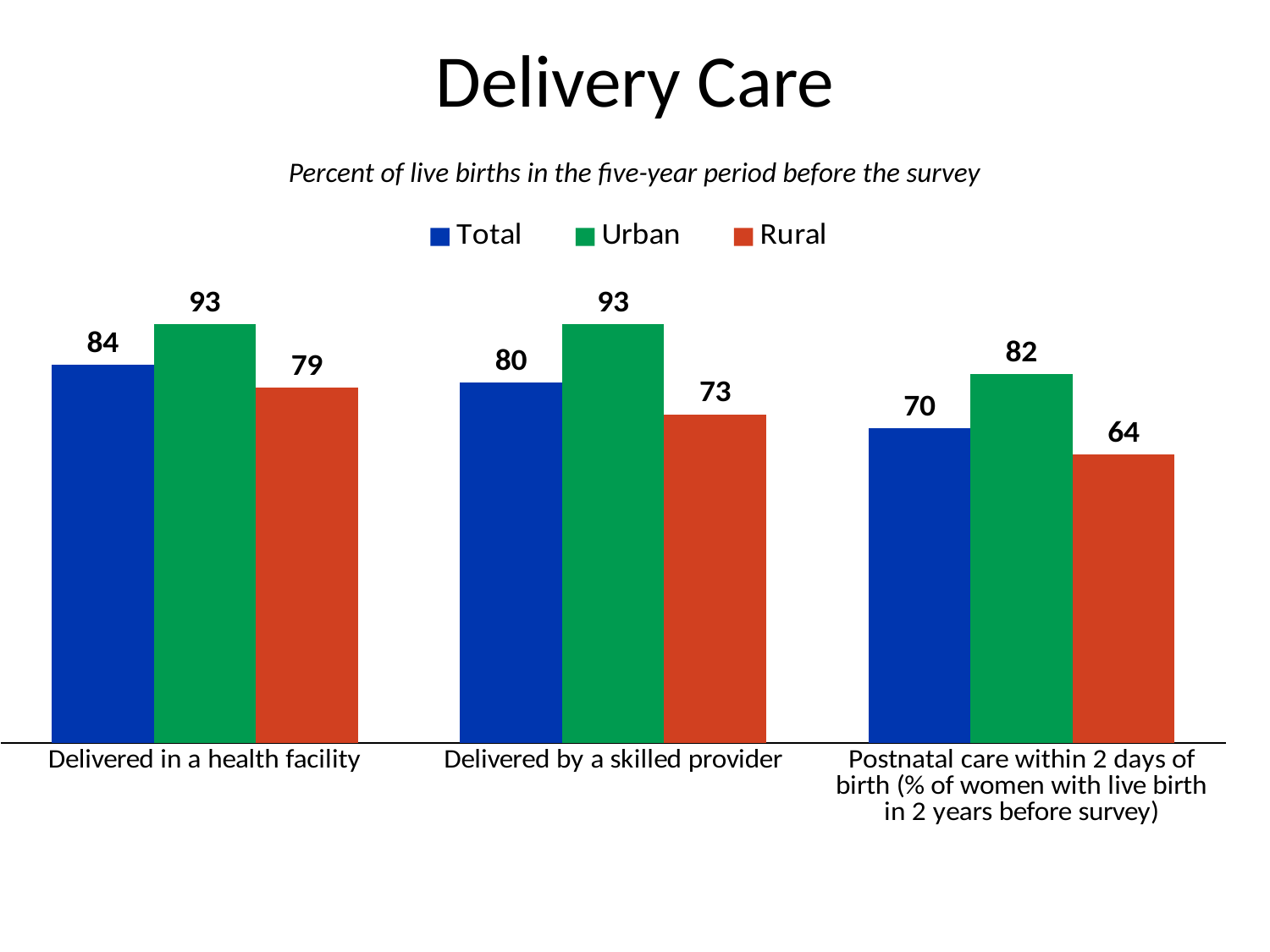
Which is larger: the Rural value for 'Delivered in a health facility' or the Rural value for 'Delivered by a skilled provider'? Delivered in a health facility What is the Urban value for 'Postnatal care within 2 days of birth'? 82 Which colour represents the Urban series? Green What is the Total value for 'Delivered in a health facility'? 84 Which series has the highest value for 'Delivered by a skilled provider'? Urban What kind of chart is shown on the slide? Bar chart Which category has the lowest Rural value? Postnatal care within 2 days of birth How many series does the legend list? 3 What is the difference between the Urban and Rural values for 'Delivered in a health facility'? 14 How many categories are shown on the x axis? 3 What is the Rural value for 'Delivered by a skilled provider'? 73 What is the difference between the Total and Rural values for 'Postnatal care within 2 days of birth'? 6